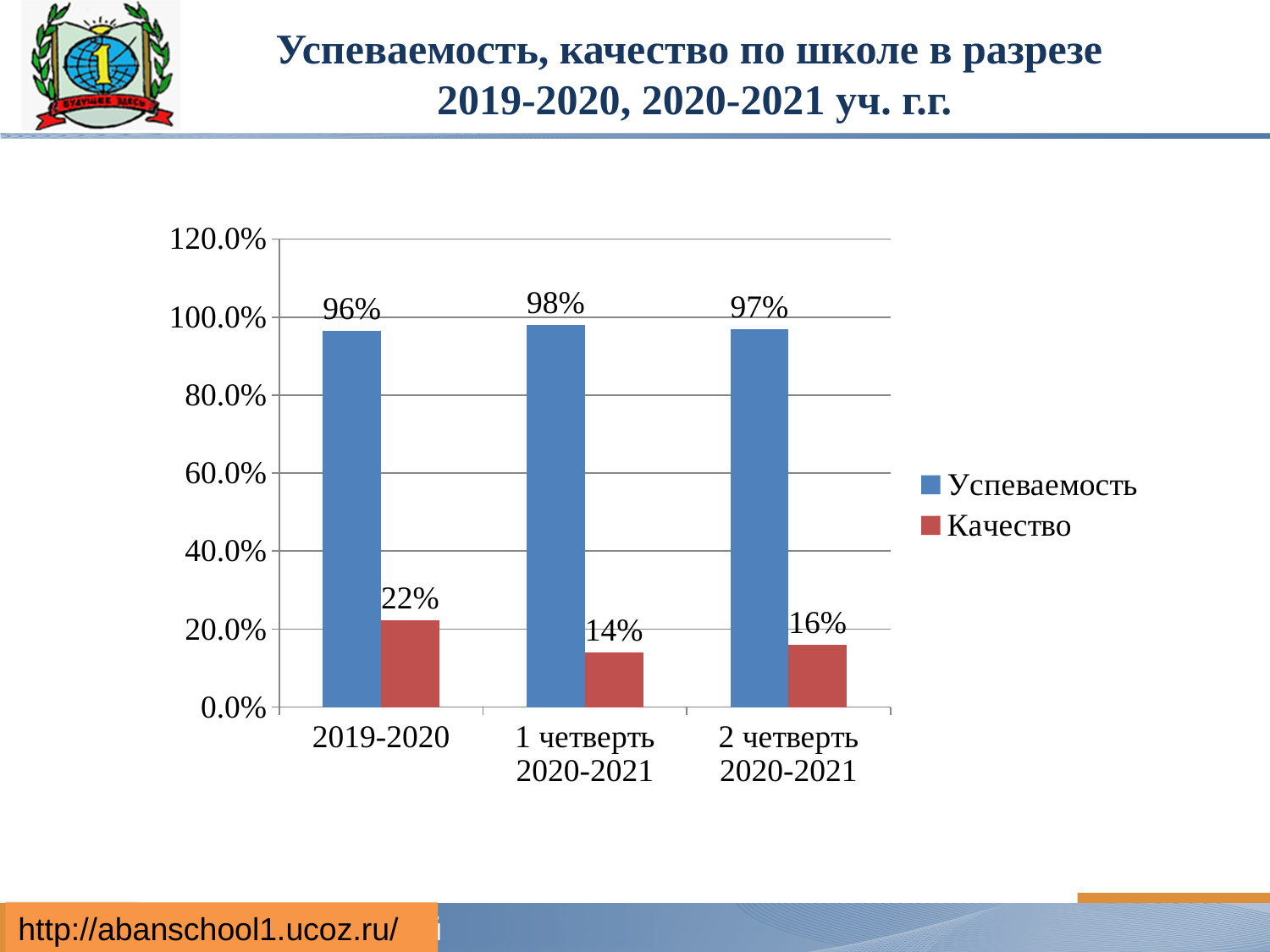
What is the Качество value for 2 четверть 2020-2021? 16% What is the Успеваемость value for 1 четверть 2020-2021? 98% Which category has the highest Качество value? 2019-2020 What is the Успеваемость value for 2019-2020? 96% Which is larger: the Успеваемость value for 1 четверть 2020-2021 or for 2 четверть 2020-2021? 1 четверть 2020-2021 Which category has the lowest Качество value? 1 четверть 2020-2021 Which colour represents the Качество series? Red How many categories are shown on the x axis? 3 What is the Качество value for 1 четверть 2020-2021? 14% What kind of chart is shown on the slide? Bar chart What is the difference between the Качество values for 2019-2020 and 1 четверть 2020-2021? 8% How many series does the legend list? 2